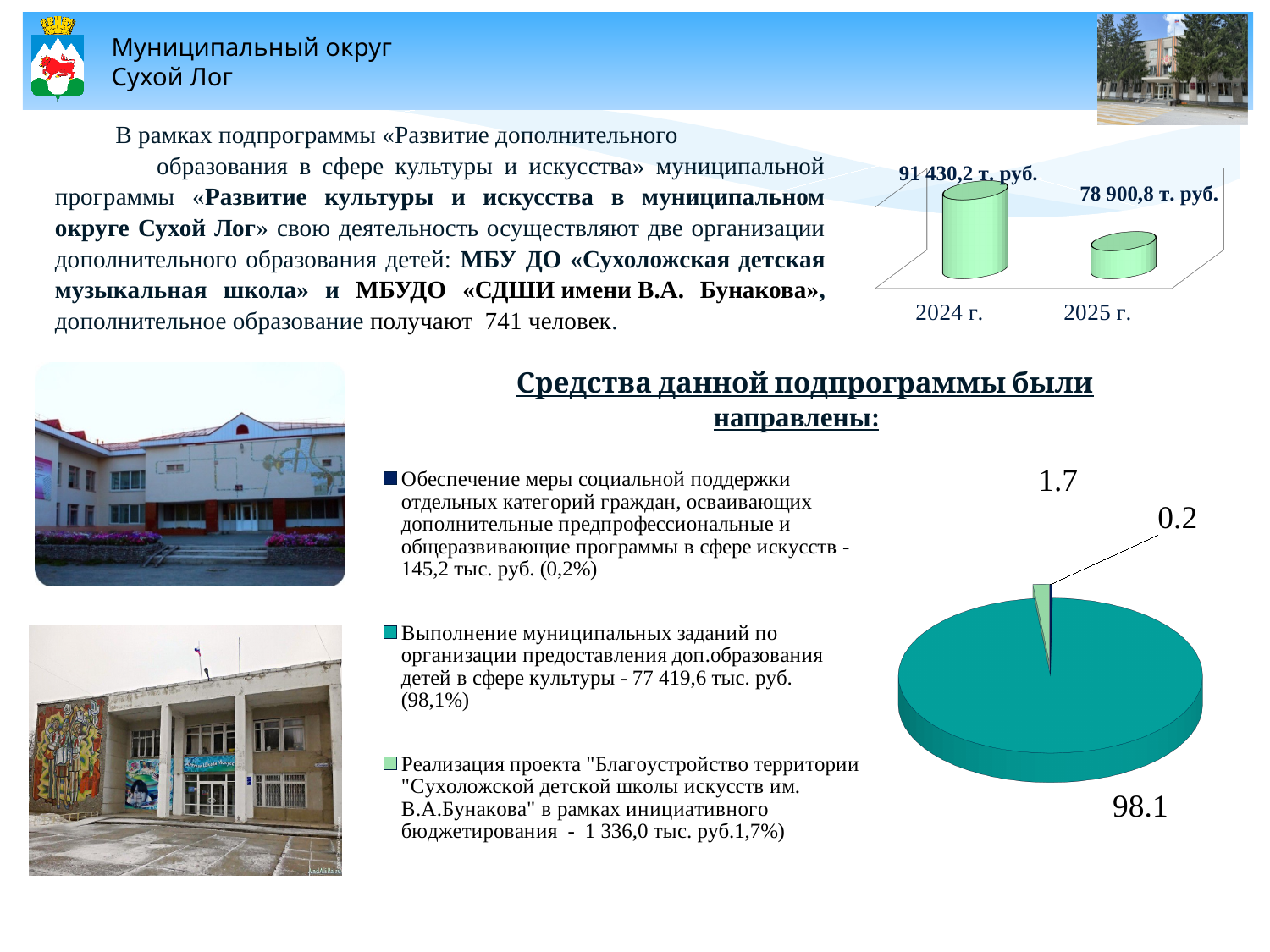
In the bar chart at the top right, what is the difference between the 2024 г. and 2025 г. values? 12 529,4 т. руб. In the bar chart at the top right, which year has the higher value? 2024 г. In the bar chart at the top right, do the values rise or fall from 2024 г. to 2025 г.? fall In the pie chart at the bottom right, which legend entry corresponds to the 98.1 slice? Выполнение муниципальных заданий по организации предоставления доп.образования детей в сфере культуры - 77 419,6 тыс. руб. (98,1%) In the pie chart at the bottom right, what is the largest slice's value? 98.1 What kind of chart is shown at the top right of the slide? bar chart In the bar chart at the top right, what is the value for 2024 г.? 91 430,2 т. руб. What kind of chart is shown at the bottom right of the slide? pie chart In the bar chart at the top right, what is the value for 2025 г.? 78 900,8 т. руб. In the pie chart at the bottom right, what is the smallest slice's value? 0.2 How many entries does the legend of the pie chart at the bottom right list? 3 How many categories does the bar chart at the top right show? 2